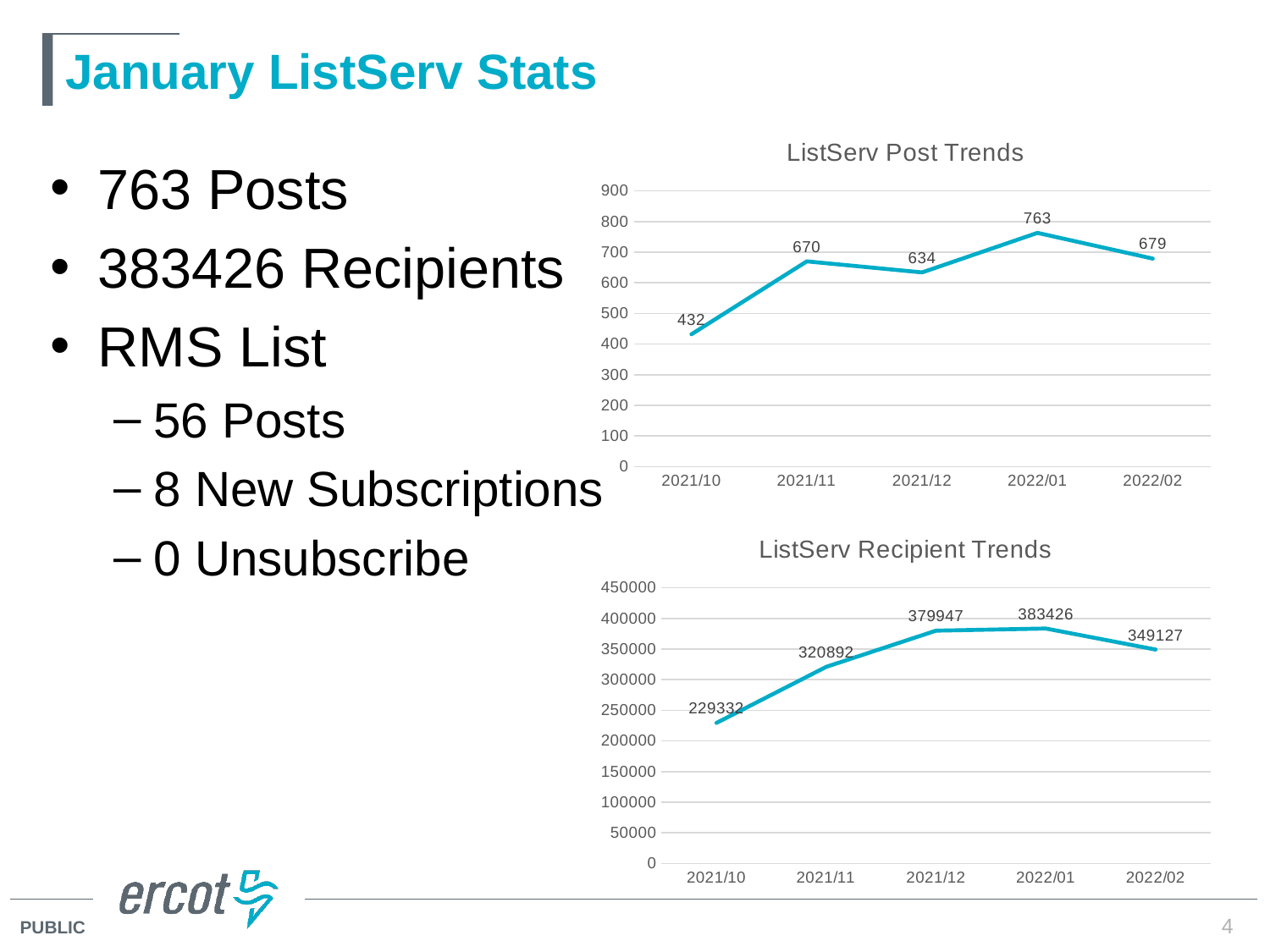
In the ListServ Recipient Trends chart, which month has the highest value? 2022/01 In the ListServ Post Trends chart, which is larger, the value for 2021/11 or 2021/12? 2021/11 In the ListServ Post Trends chart, which month has the highest value? 2022/01 In the ListServ Post Trends chart, what is the difference between the values for 2022/01 and 2022/02? 84 In the ListServ Recipient Trends chart, what is the value for 2021/12? 379947 In the ListServ Post Trends chart, which month has the lowest value? 2021/10 In the ListServ Recipient Trends chart, is the value for 2022/02 greater or less than 400000? less In the ListServ Recipient Trends chart, do the values rise or fall from 2021/10 to 2022/01? rise In the ListServ Recipient Trends chart, what is the difference between the values for 2021/11 and 2021/10? 91560 In the ListServ Post Trends chart, what is the value for 2021/10? 432 In the ListServ Post Trends chart, how many data points are plotted? 5 What kind of chart is the ListServ Post Trends chart? line chart